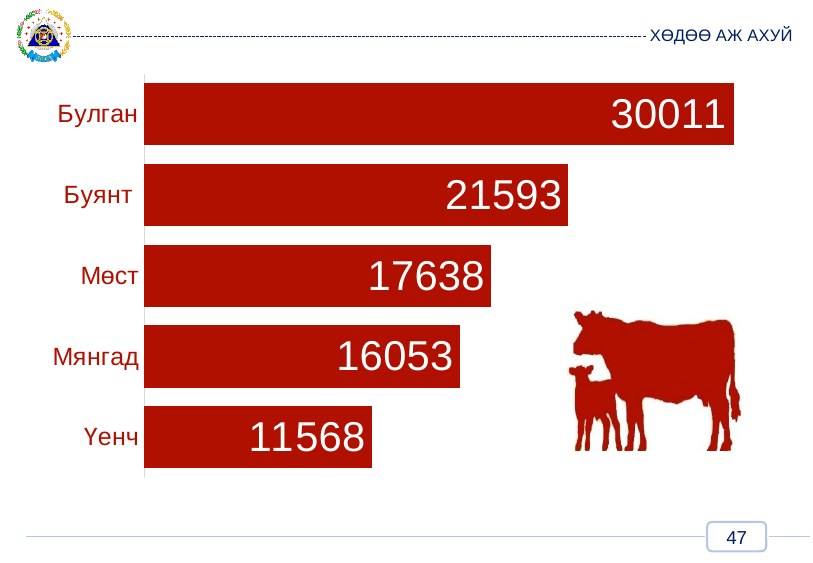
What is the value for Булган? 30011 What kind of chart is shown on the slide? bar chart Which is larger, the value for Мянгад or the value for Үенч? Мянгад What is the value for Мөст? 17638 How many categories are shown in the chart? 5 What is the value for Үенч? 11568 What is the difference between the values for Булган and Буянт? 8418 Which category has the highest value? Булган What is the value for Мянгад? 16053 What is the difference between the values for Мөст and Мянгад? 1585 Which category has the lowest value? Үенч What is the value for Буянт? 21593